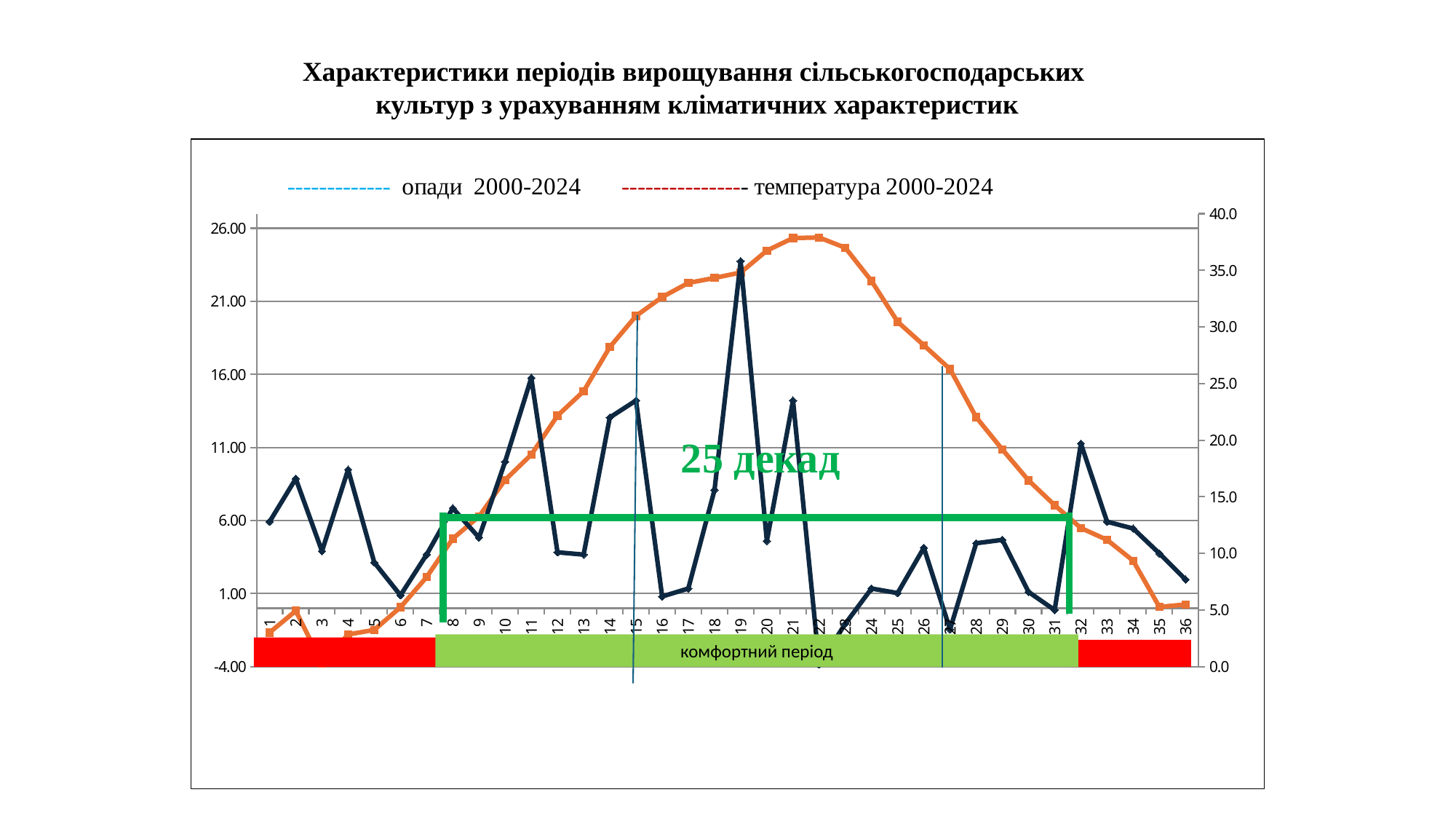
How many decades does the green annotation on the chart say the comfortable period lasts? 25 декад Which decade has the highest value for опади 2000-2024? 19 Does the температура 2000-2024 line rise or fall from decade 22 to decade 36? fall What kind of chart is shown on the slide? line chart How many decades (points) are shown along the x axis? 36 How many series does the legend list? 2 Is the опади 2000-2024 value larger at decade 19 or at decade 16? decade 19 Is the температура 2000-2024 value larger at decade 20 or at decade 5? decade 20 What is the highest value shown on the left vertical axis? 26.00 What are the two series named in the legend? опади 2000-2024 and температура 2000-2024 Is the температура 2000-2024 value larger at decade 11 or at decade 33? decade 11 Does the температура 2000-2024 line rise or fall from decade 1 to decade 21? rise